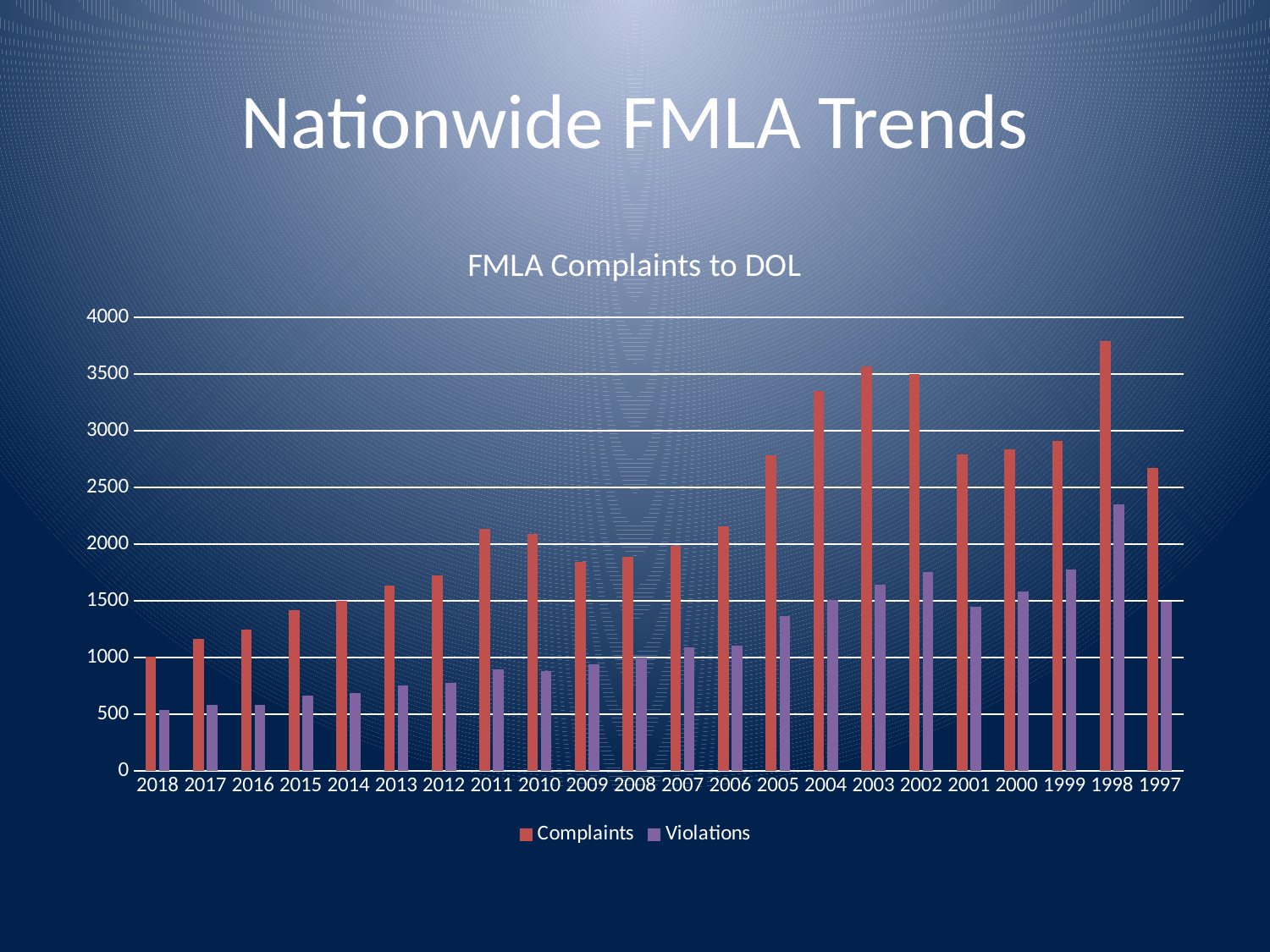
Is the value for Complaints in 2004 greater or less than 3000? greater Which year has the highest value for Complaints? 1998 Is the value for Violations in 2002 greater or less than 1500? greater How many years are shown on the x axis? 22 Which year has the highest value for Violations? 1998 What kind of chart is shown on the slide? bar chart What is the title of the chart? FMLA Complaints to DOL Which year has the lowest value for Complaints? 2018 Is the value for Violations in 2018 greater or less than 1000? less How many series does the legend list? 2 Moving along the x axis from 2018 to 2011, do the Complaints values rise or fall? rise Which is larger, Complaints in 2005 or Complaints in 2006? 2005